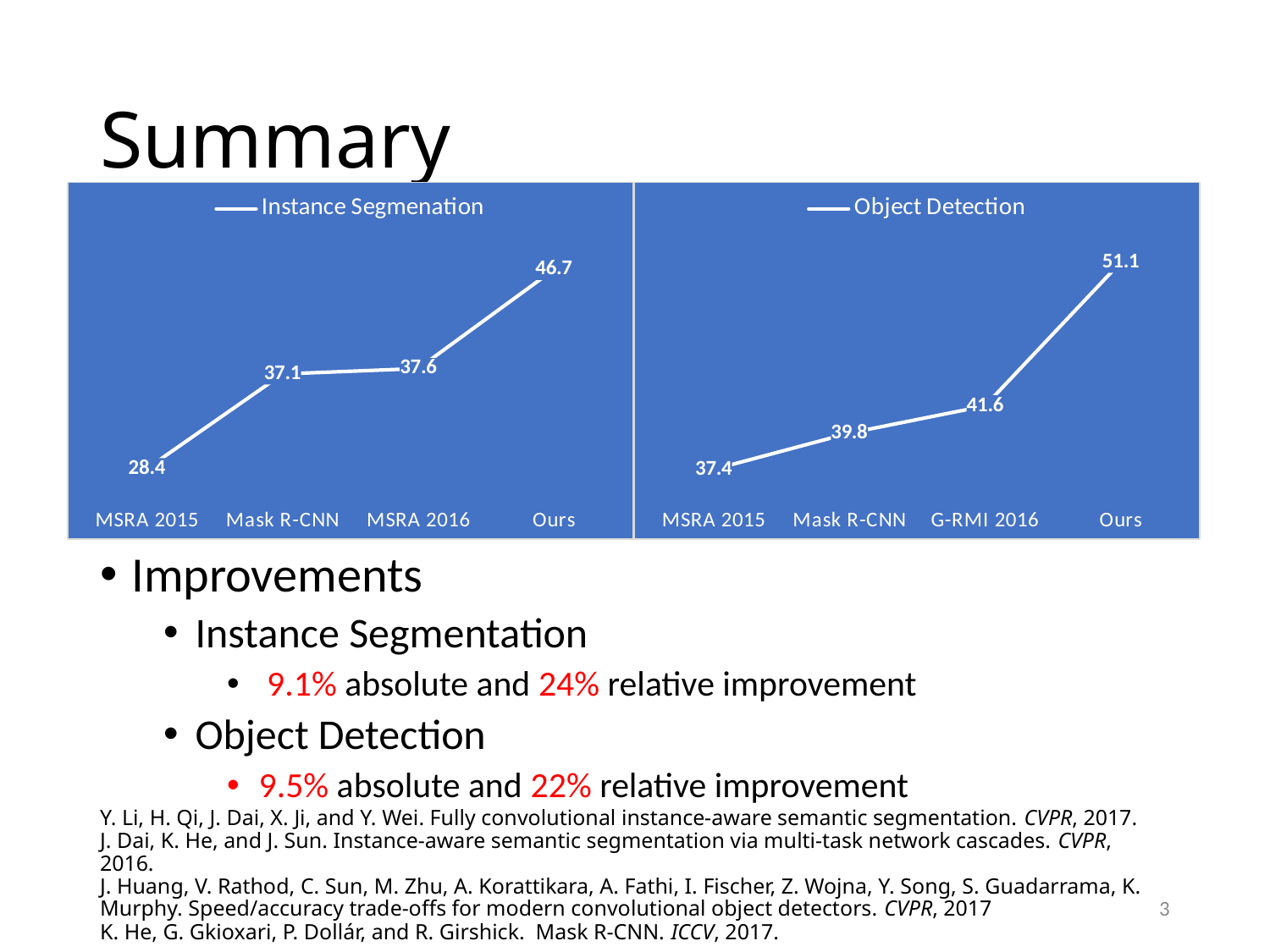
In the Instance Segmentation chart, what is the difference between the values for MSRA 2016 and Mask R-CNN? 0.5 In the Object Detection chart, do the values rise or fall from MSRA 2015 to Ours? Rise In the Instance Segmentation chart, which category has the lowest value? MSRA 2015 In the Object Detection chart, what is the value for Mask R-CNN? 39.8 In the Object Detection chart, what is the value for G-RMI 2016? 41.6 In the Instance Segmentation chart, what is the value for Ours? 46.7 What kind of chart is the Instance Segmentation chart? Line chart In the Instance Segmentation chart, what is the value for MSRA 2015? 28.4 How many categories are shown on the x axis of the Object Detection chart? 4 In the Object Detection chart, which category has the highest value? Ours In the Instance Segmentation chart, which is larger, the value for Mask R-CNN or the value for Ours? Ours In the Object Detection chart, what is the difference between the values for Ours and MSRA 2015? 13.7